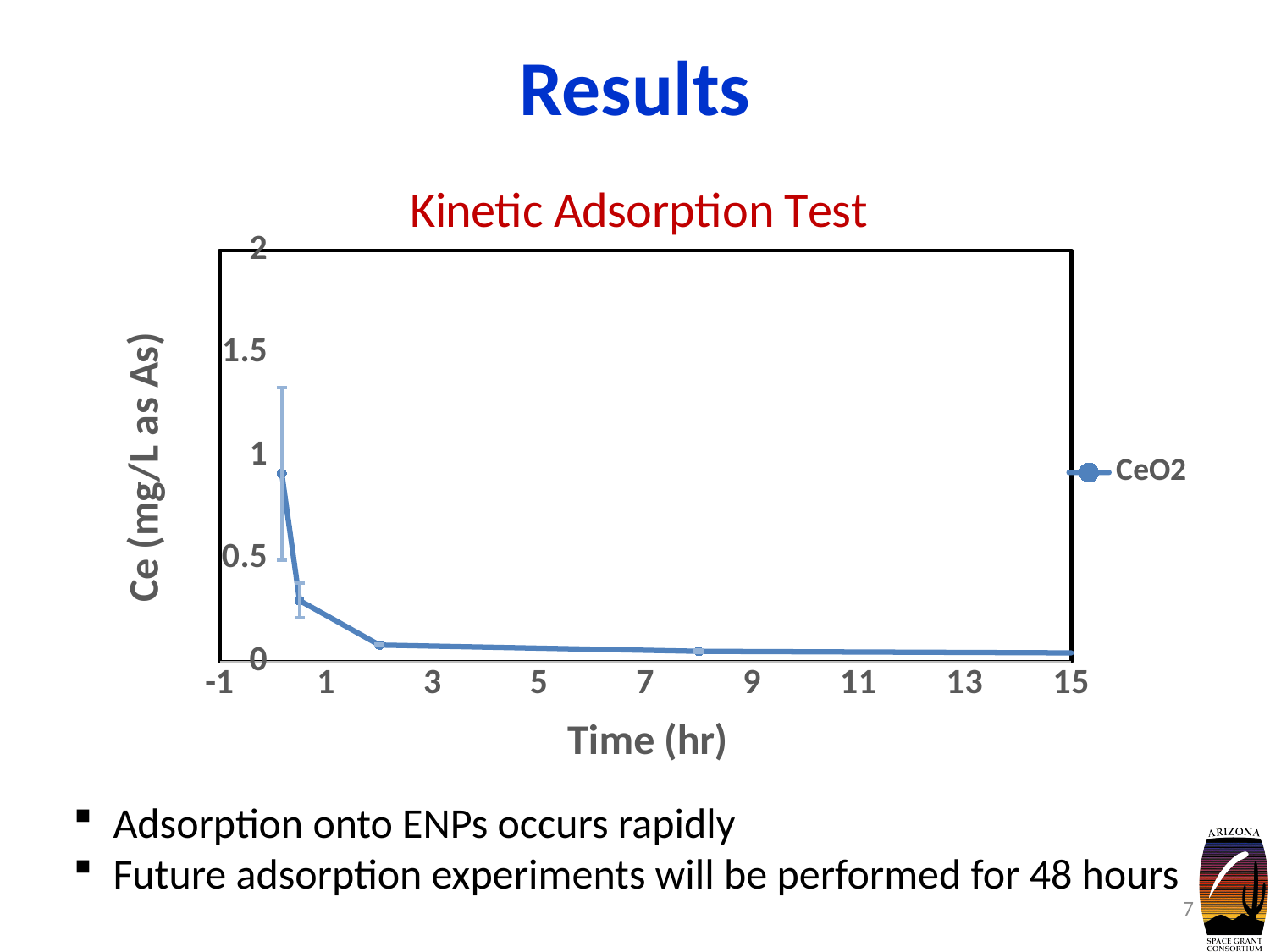
Is the Ce value at time 2 hr greater or less than 0.5? less What is the title of the chart? Kinetic Adsorption Test What series name appears in the chart legend? CeO2 What kind of chart is shown on the slide? line chart How many series does the chart legend list? 1 Is the Ce value at time 15 hr greater or less than 0.5? less Do the Ce values rise or fall as time increases along the x axis? fall